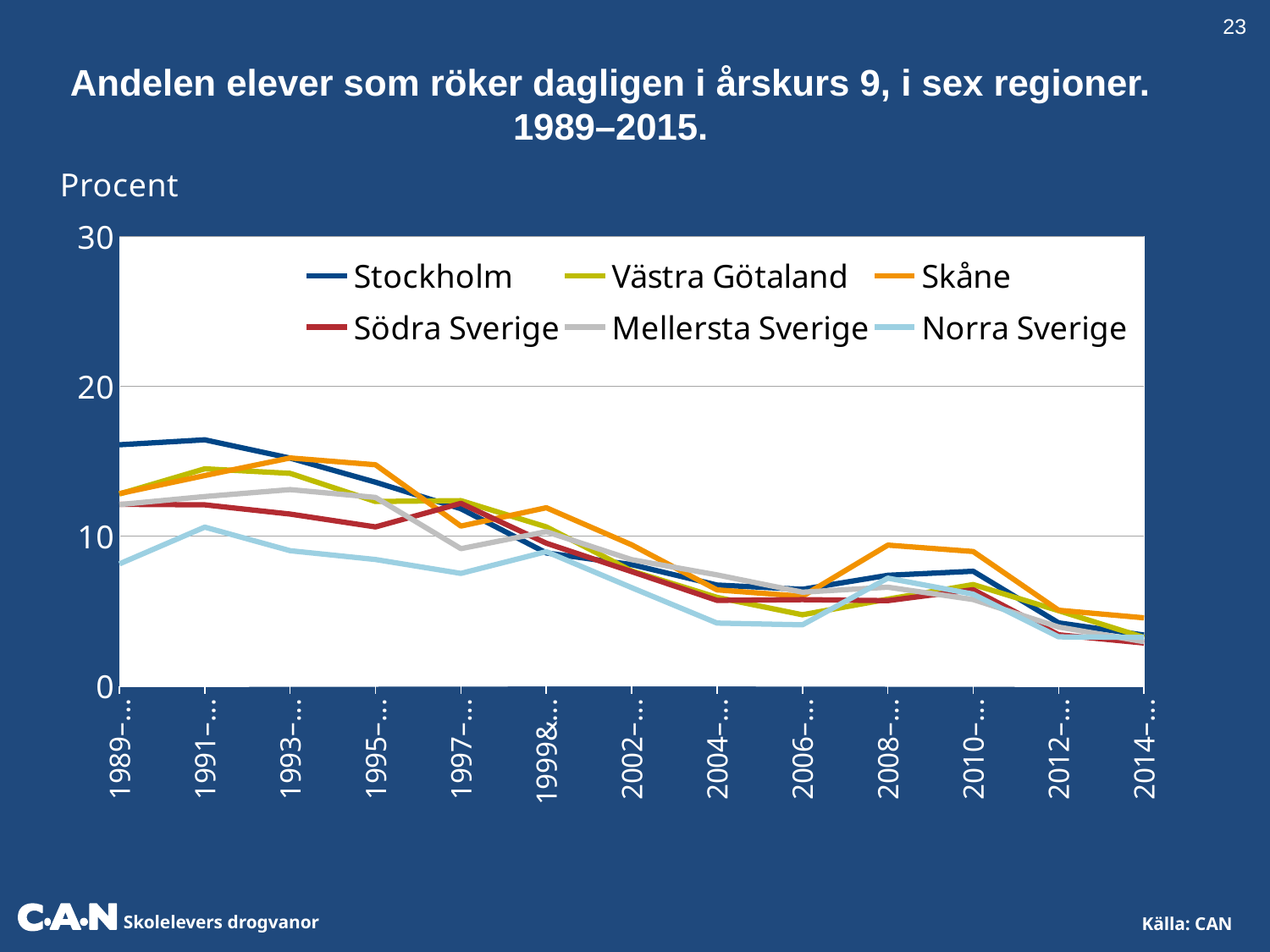
Which series is highest at the first point (1989)? Stockholm Is the value for Norra Sverige at 2004 greater or less than 10? less Overall, do the values rise or fall from 1989 to 2014? Fall What kind of chart is shown on the slide? Line chart What is the title of the chart? Andelen elever som röker dagligen i årskurs 9, i sex regioner. 1989–2015. At 1989, which is larger: the value for Stockholm or the value for Norra Sverige? Stockholm Is the value for Stockholm at 1991 greater or less than 10? greater What is the label on the vertical axis of the chart? Procent Which series is lowest at the first point (1989)? Norra Sverige Is the value for Norra Sverige at 1989 greater or less than 10? less How many series does the legend list? 6